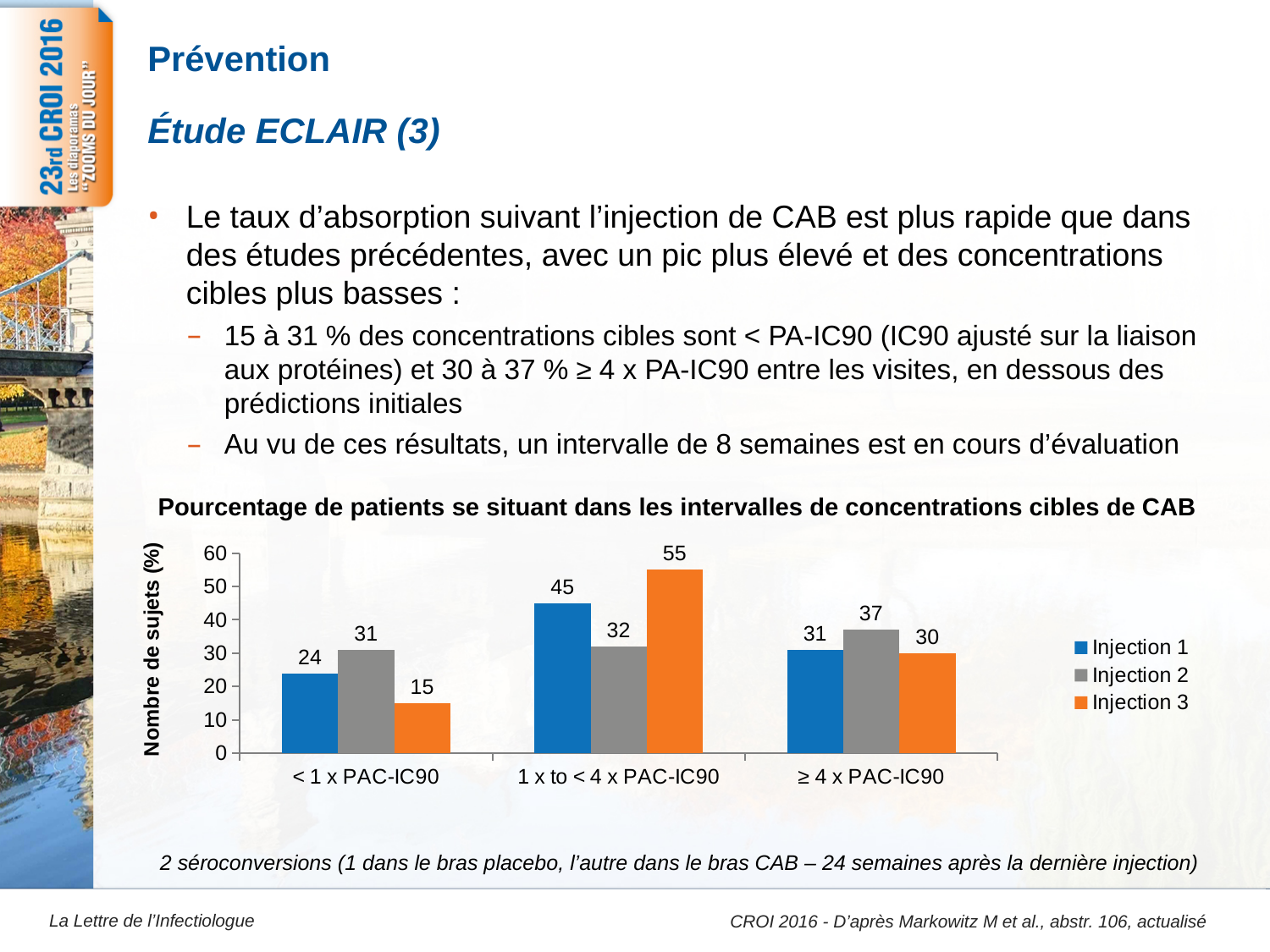
How many categories are shown on the x axis of the chart? 3 What is the value for Injection 3 in the "1 x to < 4 x PAC-IC90" category? 55 How many series does the chart legend list? 3 Which series has the highest value in the "1 x to < 4 x PAC-IC90" category? Injection 3 Which is larger: Injection 1 in "1 x to < 4 x PAC-IC90" or Injection 1 in "≥ 4 x PAC-IC90"? Injection 1 in "1 x to < 4 x PAC-IC90" Which series has the lowest value in the "< 1 x PAC-IC90" category? Injection 3 What is the difference between Injection 3 and Injection 2 in the "1 x to < 4 x PAC-IC90" category? 23 What is the value for Injection 1 in the "< 1 x PAC-IC90" category? 24 What is the value for Injection 2 in the "≥ 4 x PAC-IC90" category? 37 What is the title of the chart? Pourcentage de patients se situant dans les intervalles de concentrations cibles de CAB What kind of chart is shown on the slide? Bar chart Is the value for Injection 3 in the "1 x to < 4 x PAC-IC90" category greater or less than 50? greater